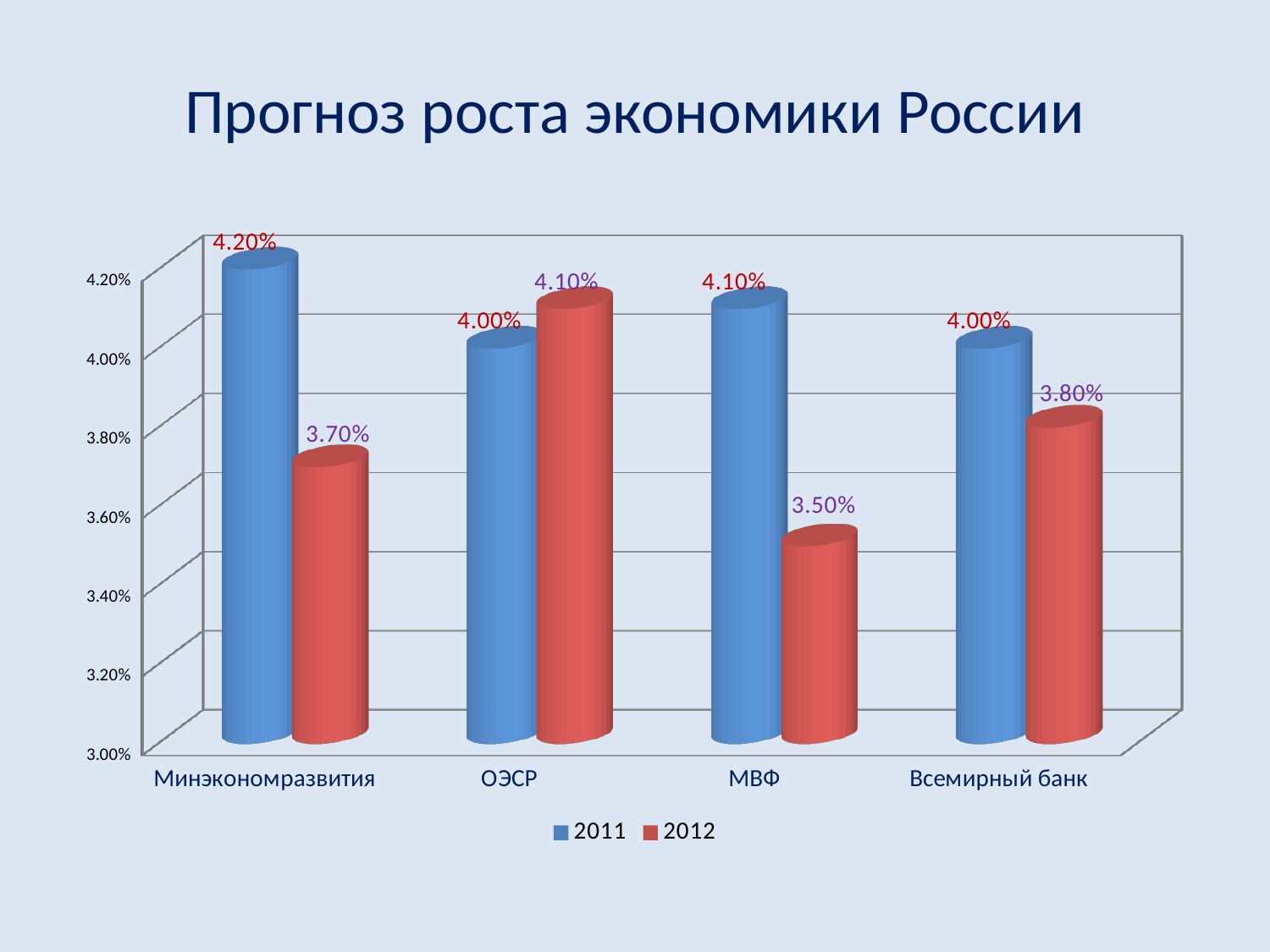
What is the difference between the 2011 and 2012 values for МВФ? 0.60% What is the 2011 value for Всемирный банк? 4.00% How many series does the legend list? 2 What is the title of the chart? Прогноз роста экономики России What is the 2012 value for ОЭСР? 4.10% How many categories are shown on the x axis? 4 What is the 2012 value for МВФ? 3.50% What kind of chart is shown on the slide? Bar chart Which category has the highest 2011 value? Минэкономразвития What is the 2011 value for Минэкономразвития? 4.20% Which category has the lowest 2012 value? МВФ Which is larger for ОЭСР, the 2011 value or the 2012 value? 2012